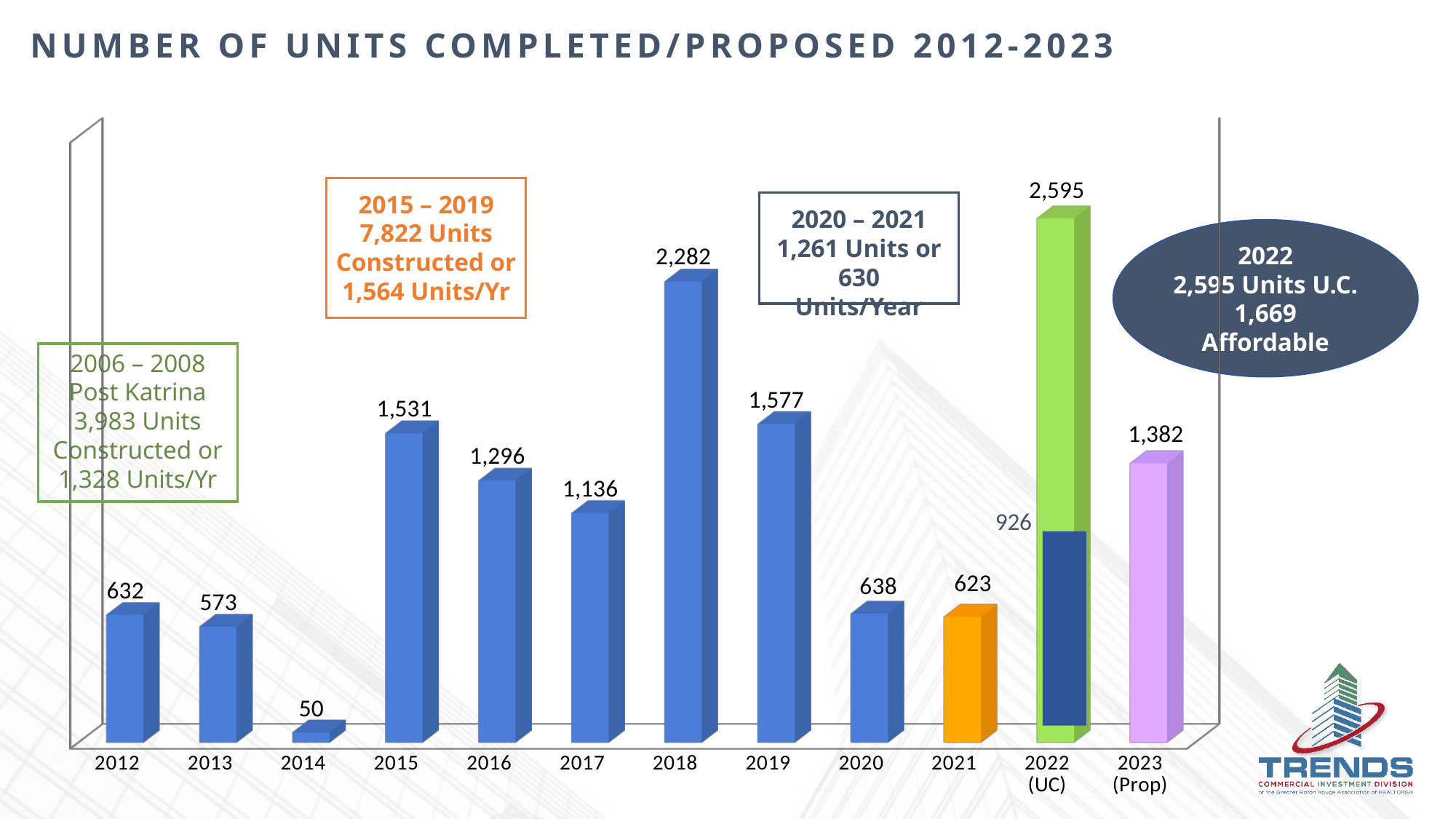
What kind of chart is shown on the slide? Bar chart What is the total of the stacked bar for 2022 (UC)? 2,595 What is the difference between the values for 2012 and 2013? 59 How many years are shown on the x axis? 12 Do the values rise or fall from 2018 to 2021? Fall What is the number of units for 2018? 2,282 What is the difference between the values for 2018 and 2019? 705 Which year has the highest bar? 2022 (UC) What value is shown for 2023 (Prop)? 1,382 Which is larger, the value for 2015 or the value for 2016? 2015 What is the number of units for 2014? 50 Which year has the lowest number of units? 2014